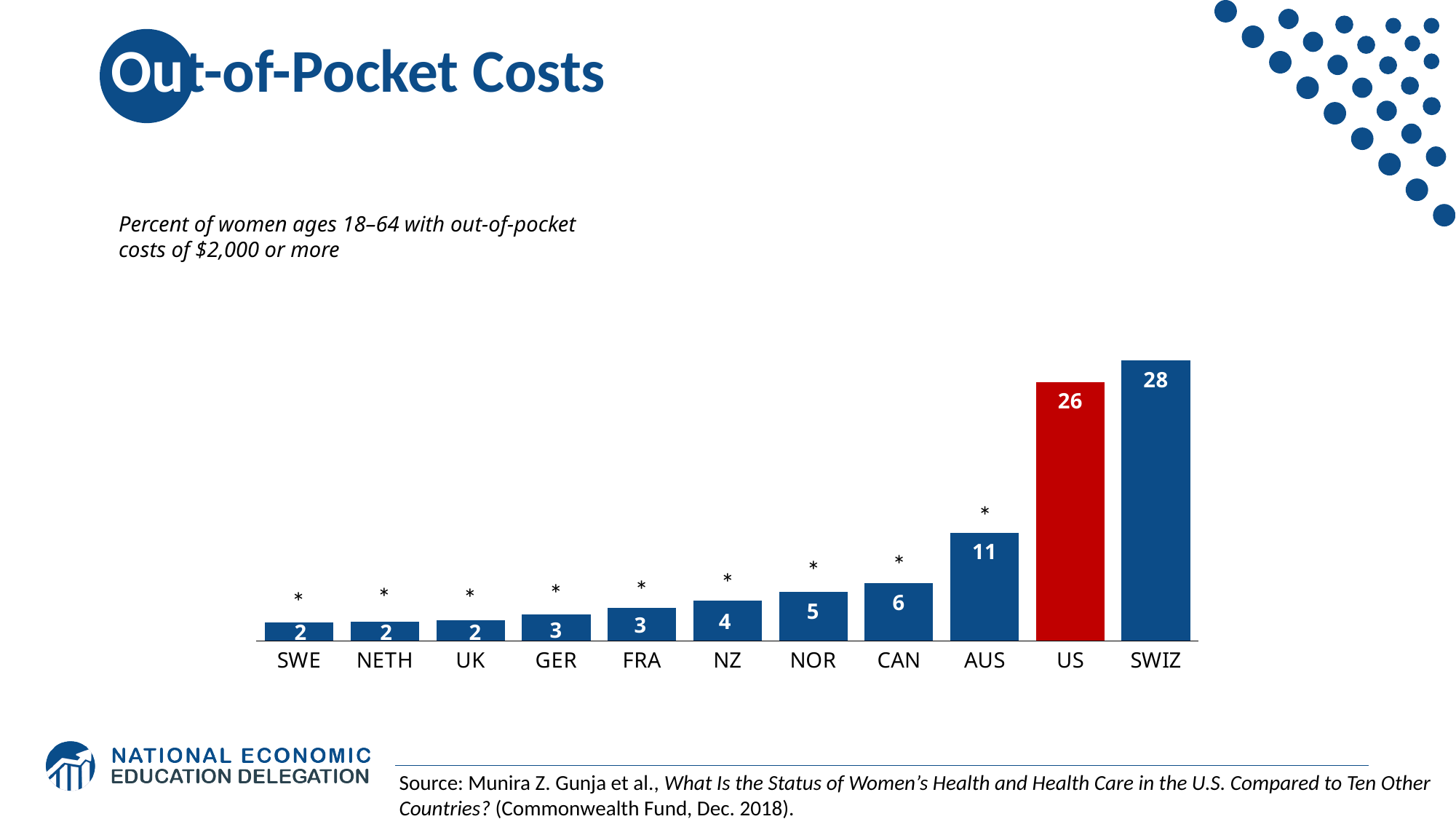
What is the title of the slide? Out-of-Pocket Costs Which country has the highest value? SWIZ Which bar is coloured red rather than blue? US What kind of chart is shown on the slide? Bar chart Which has a larger value, CAN or NZ? CAN Do the values rise or fall from left to right along the x axis? Rise What is the value for AUS? 11 What is the value for the US? 26 What is the difference between the values for SWIZ and the US? 2 How many countries are shown on the chart? 11 What is the value for NOR? 5 What is the difference between the values for the US and AUS? 15